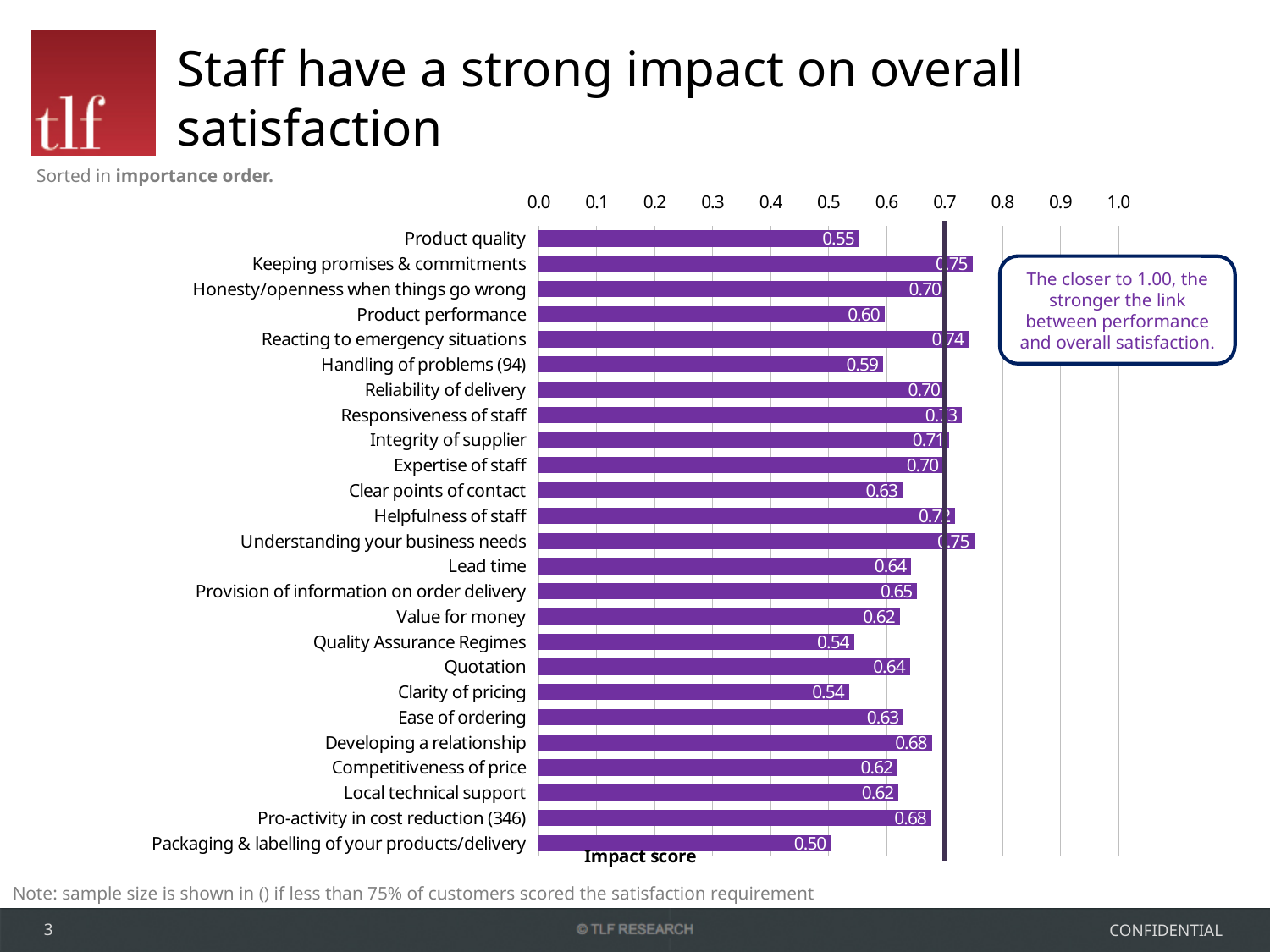
How many categories are shown in the chart? 25 What is the impact score for Packaging & labelling of your products/delivery? 0.50 What is the label on the horizontal axis of the chart? Impact score What kind of chart is shown on the slide? Bar chart Is the impact score for Keeping promises & commitments greater or less than 0.7? greater What is the impact score for Clear points of contact? 0.63 Which has a higher impact score, Developing a relationship or Clarity of pricing? Developing a relationship What is the impact score for Product quality? 0.55 What is the impact score for Honesty/openness when things go wrong? 0.70 Which category has the lowest impact score? Packaging & labelling of your products/delivery What is the impact score for Developing a relationship? 0.68 What is the difference between the impact scores for Product quality and Packaging & labelling of your products/delivery? 0.05